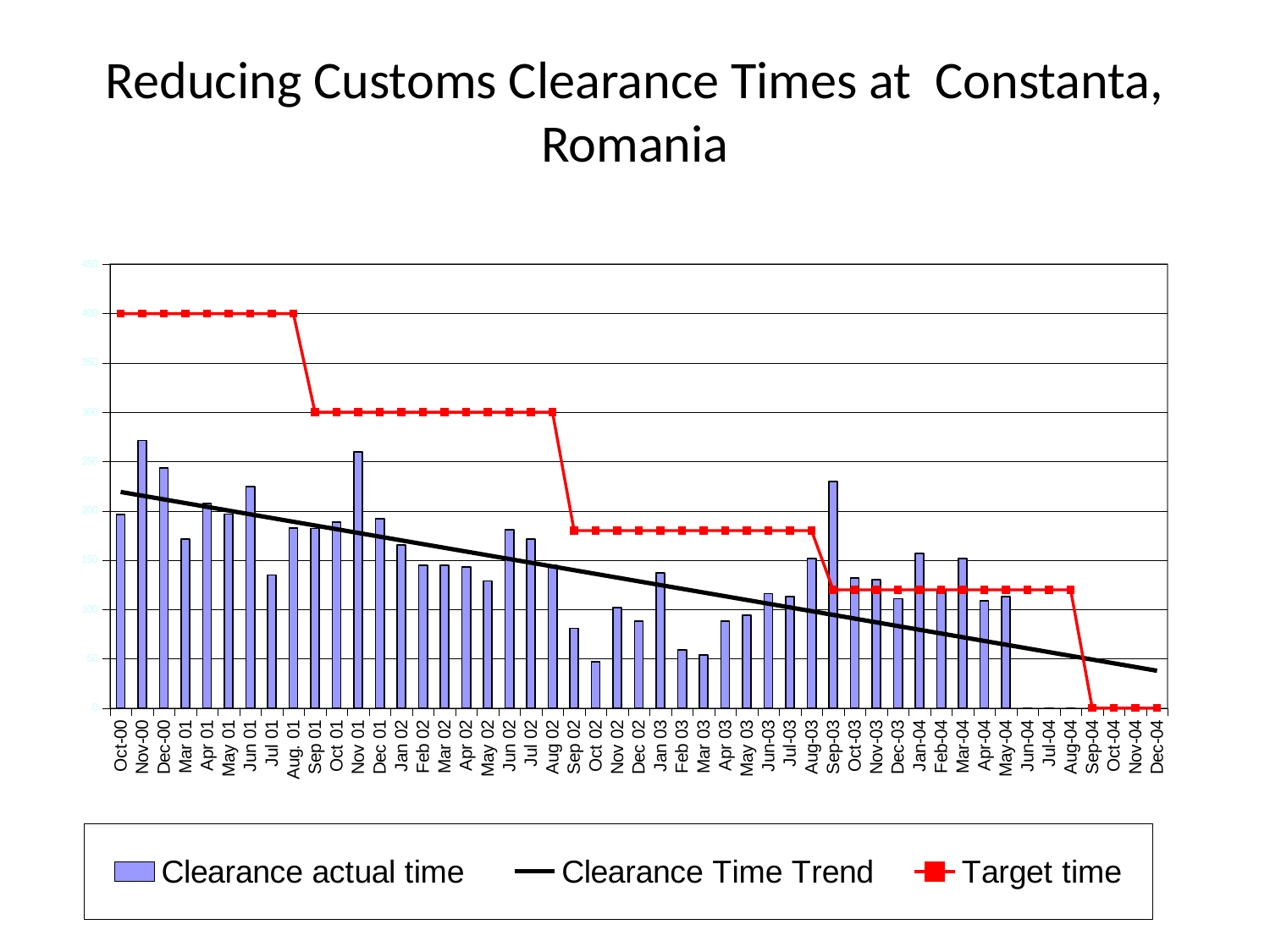
Does the Target time line rise or fall over the period shown? falls By how much does the Target time drop between Oct-00 and Dec 01? 100 Does the Clearance Time Trend line rise or fall from left to right? falls Which has the larger Clearance actual time, Sep-03 or Oct-03? Sep-03 Is the Clearance actual time for Nov-00 greater or less than 250? greater What is the Target time value for Dec-04? 0 How many series does the legend list? 3 What kind of chart is used to show the Clearance actual time series? bar chart What are the three entries in the chart legend? Clearance actual time, Clearance Time Trend, Target time What is the title of the slide containing the chart? Reducing Customs Clearance Times at Constanta, Romania What is the Target time value for Oct-00? 400 What is the Target time value for Dec 01? 300